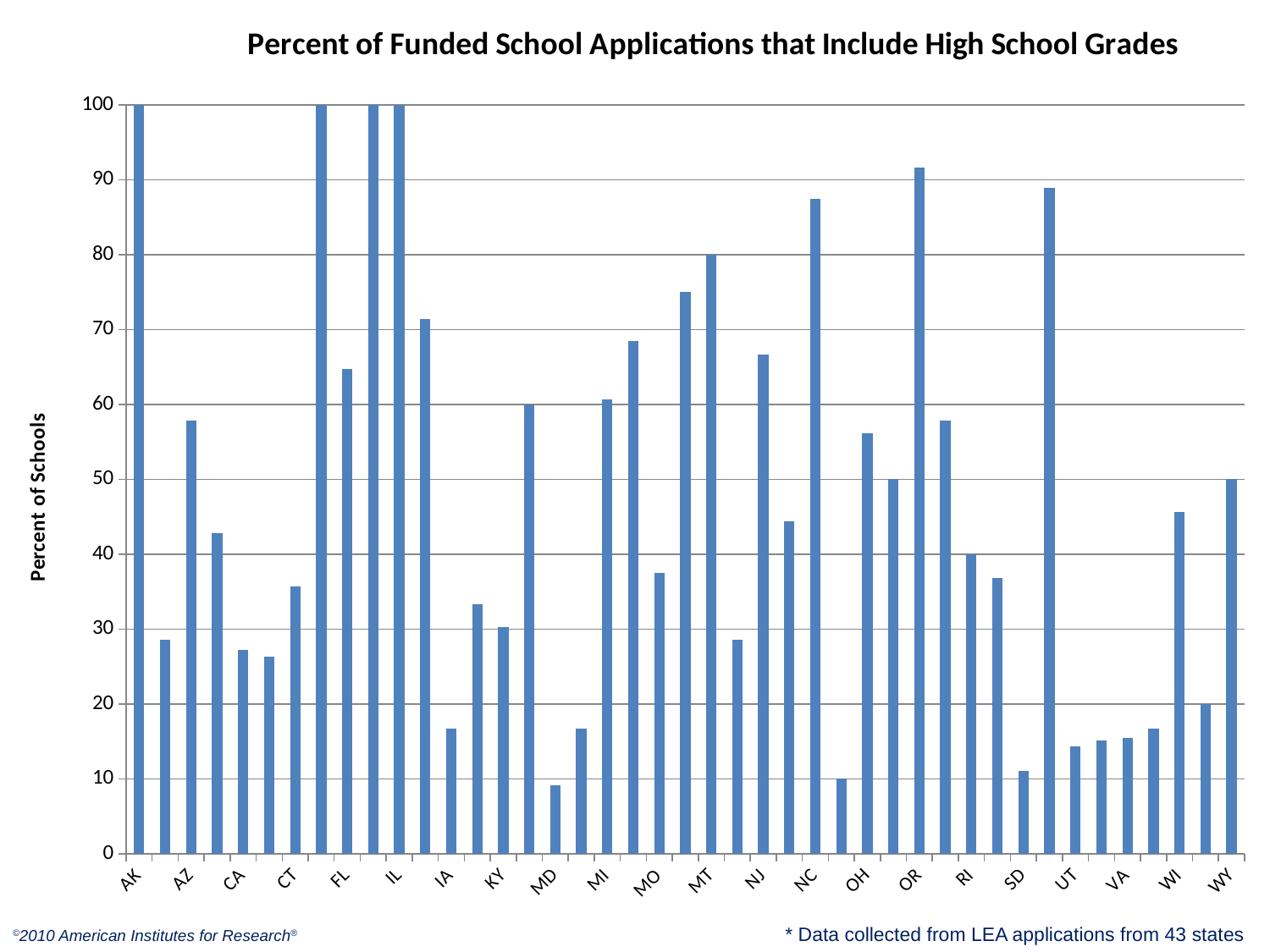
What is the label on the vertical axis? Percent of Schools What is the difference between the values for AK and WY? 50 How many states (bars) are plotted in the chart? 43 Which is larger, the value for AZ or the value for CA? AZ Is the value for NC greater or less than 80? greater What is the value for RI? 40 Is the value for IA greater or less than 20? less What kind of chart is shown on the slide? bar chart What is the value for WY? 50 What is the title of the chart? Percent of Funded School Applications that Include High School Grades What is the value for IL? 100 What is the value for AK? 100